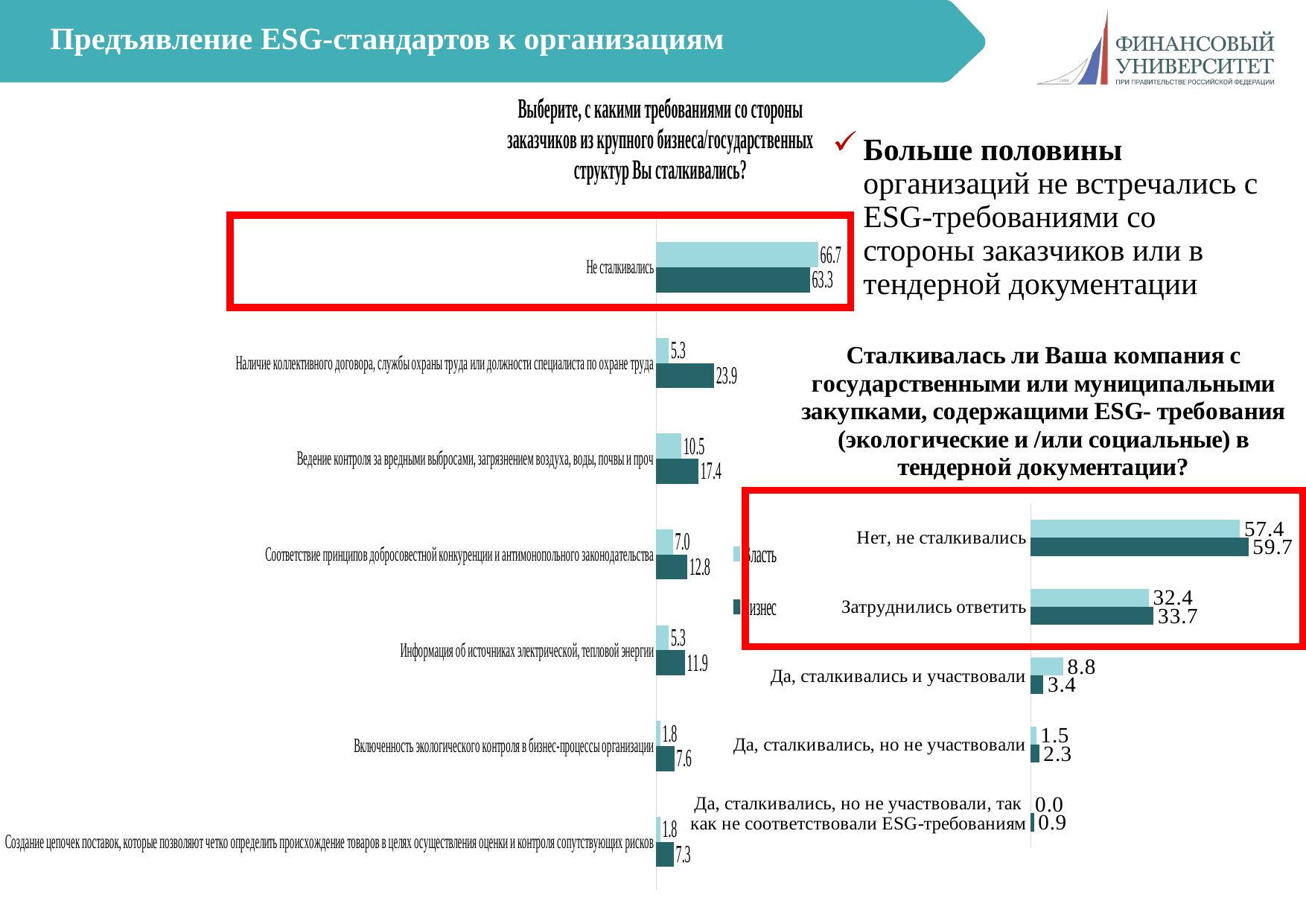
In the left chart, which category has the highest value for the dark-coloured bars? Не сталкивались In the left chart, how many categories are shown? 7 In the left chart, what is the value of the light-coloured bar for "Не сталкивались"? 66.7 In the right chart, which category has the lowest value for the light-coloured bars? Да, сталкивались, но не участвовали, так как не соответствовали ESG-требованиям In the right chart, what is the value of the dark-coloured bar for "Нет, не сталкивались"? 59.7 In the right chart, how many categories are shown? 5 In the left chart, what is the value of the dark-coloured bar for "Наличие коллективного договора, службы охраны труда или должности специалиста по охране труда"? 23.9 In the right chart, what is the difference between the light and dark bars for "Нет, не сталкивались"? 2.3 In the left chart, what is the difference between the light and dark bars for "Ведение контроля за вредными выбросами, загрязнением воздуха, воды, почвы и проч"? 6.9 In the right chart, what is the value of the light-coloured bar for "Затруднились ответить"? 32.4 In the right chart, which is larger for "Да, сталкивались и участвовали": the light-coloured bar or the dark-coloured bar? The light-coloured bar What type of chart is the left chart? Bar chart